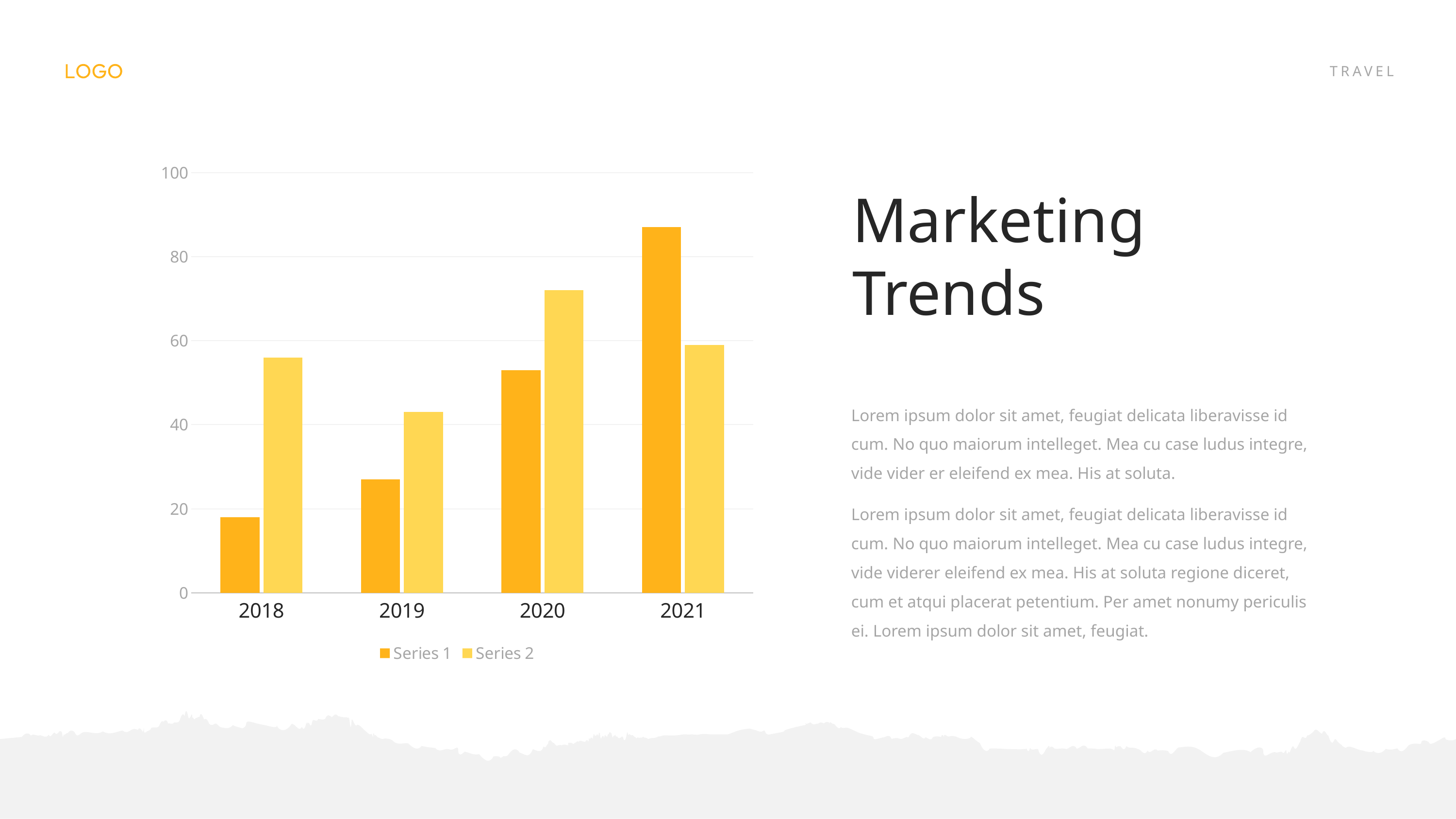
Which year has the highest value for Series 2? 2020 Which year has the lowest value for Series 2? 2019 Is the value for Series 1 in 2021 greater or less than 80? greater Which year has the highest value for Series 1? 2021 Is the value for Series 2 in 2020 greater or less than 60? greater Do the Series 1 values rise or fall from 2018 to 2021? rise What kind of chart is shown on the slide? bar chart Which year has the lowest value for Series 1? 2018 In 2018, which is larger, Series 1 or Series 2? Series 2 Is the value for Series 1 in 2018 greater or less than 20? less How many years are shown on the x axis? 4 How many series does the legend list? 2